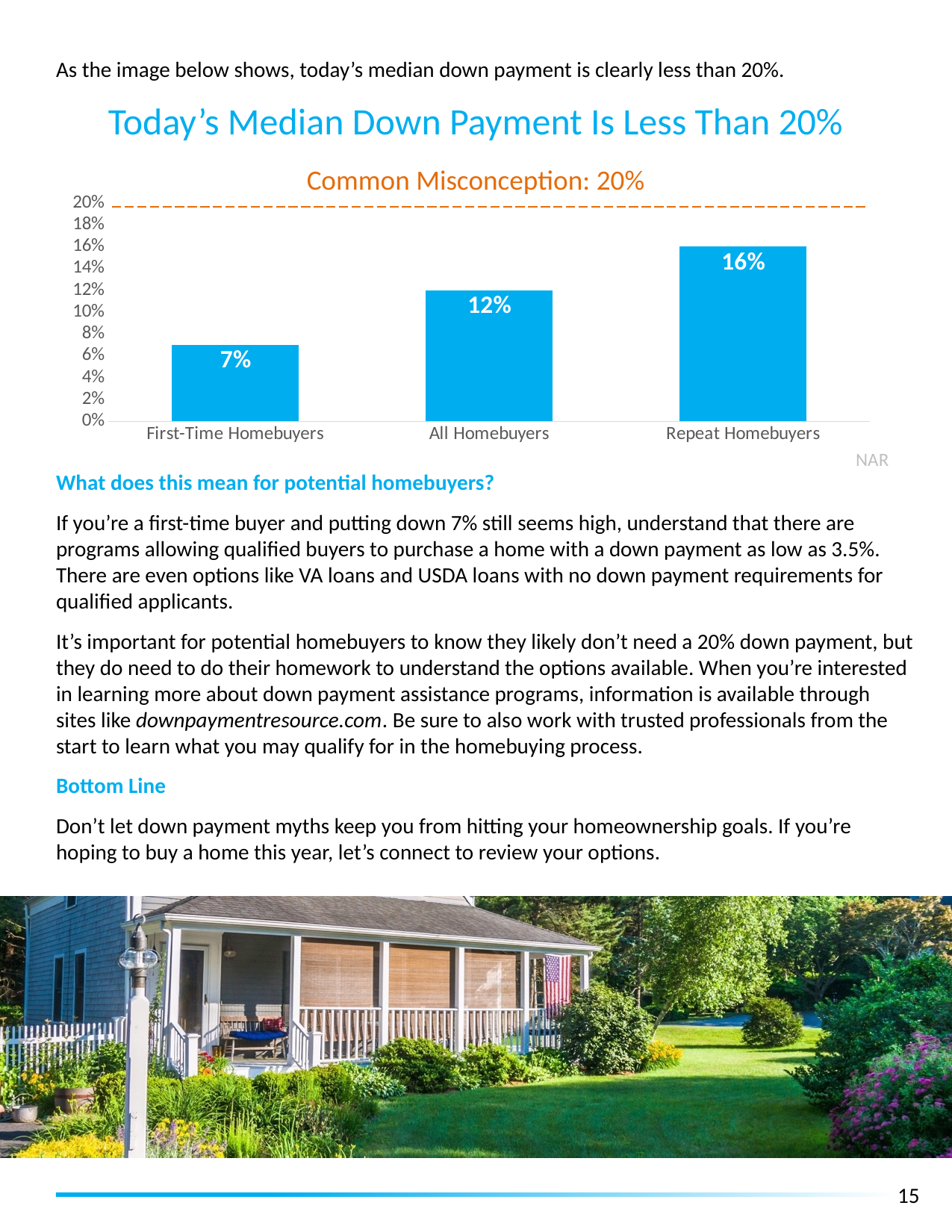
Is the value for Repeat Homebuyers greater or less than 20%? less What is the median down payment for Repeat Homebuyers? 16% What is the difference between the median down payment for Repeat Homebuyers and First-Time Homebuyers? 9% Which is larger, the median down payment for All Homebuyers or for Repeat Homebuyers? Repeat Homebuyers What kind of chart is shown on the slide? Bar chart What is the difference between the median down payment for All Homebuyers and First-Time Homebuyers? 5% How many categories are shown in the chart? 3 What value does the orange dashed line labeled 'Common Misconception' mark? 20% What is the median down payment for First-Time Homebuyers? 7% Which category has the highest median down payment? Repeat Homebuyers Which category has the lowest median down payment? First-Time Homebuyers What is the median down payment for All Homebuyers? 12%